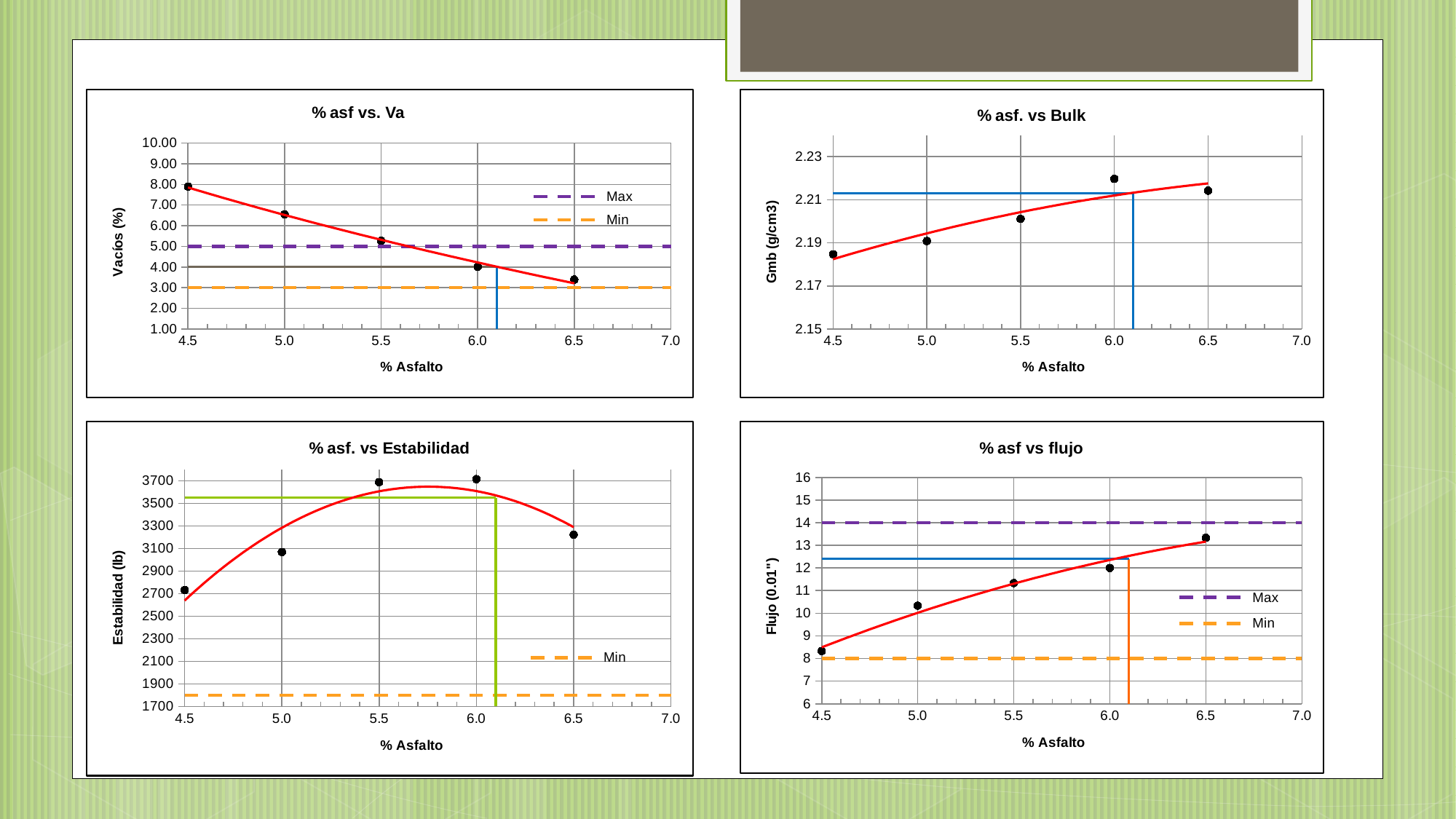
In the '% asf. vs Estabilidad' chart, which % Asfalto has the lowest Estabilidad value? 4.5 In the '% asf vs. Va' chart, how many data points are plotted? 5 In the '% asf vs. Va' chart, how many entries does the legend list? 2 In the '% asf vs flujo' chart, do the values rise or fall as % Asfalto increases? rise In the '% asf. vs Bulk' chart, which % Asfalto has the lowest Gmb value? 4.5 In the '% asf vs flujo' chart, which % Asfalto has the highest Flujo value? 6.5 In the '% asf vs. Va' chart, which % Asfalto has the lowest Vacíos value? 6.5 In the '% asf. vs Estabilidad' chart, is the value at 5.0% Asfalto greater or less than 2900? greater In the '% asf. vs Bulk' chart, is the value at 6.0% Asfalto greater or less than 2.21? greater In the '% asf vs. Va' chart, do the values rise or fall as % Asfalto increases? fall In the '% asf vs flujo' chart, is the value at 5.0% Asfalto greater or less than 11? less